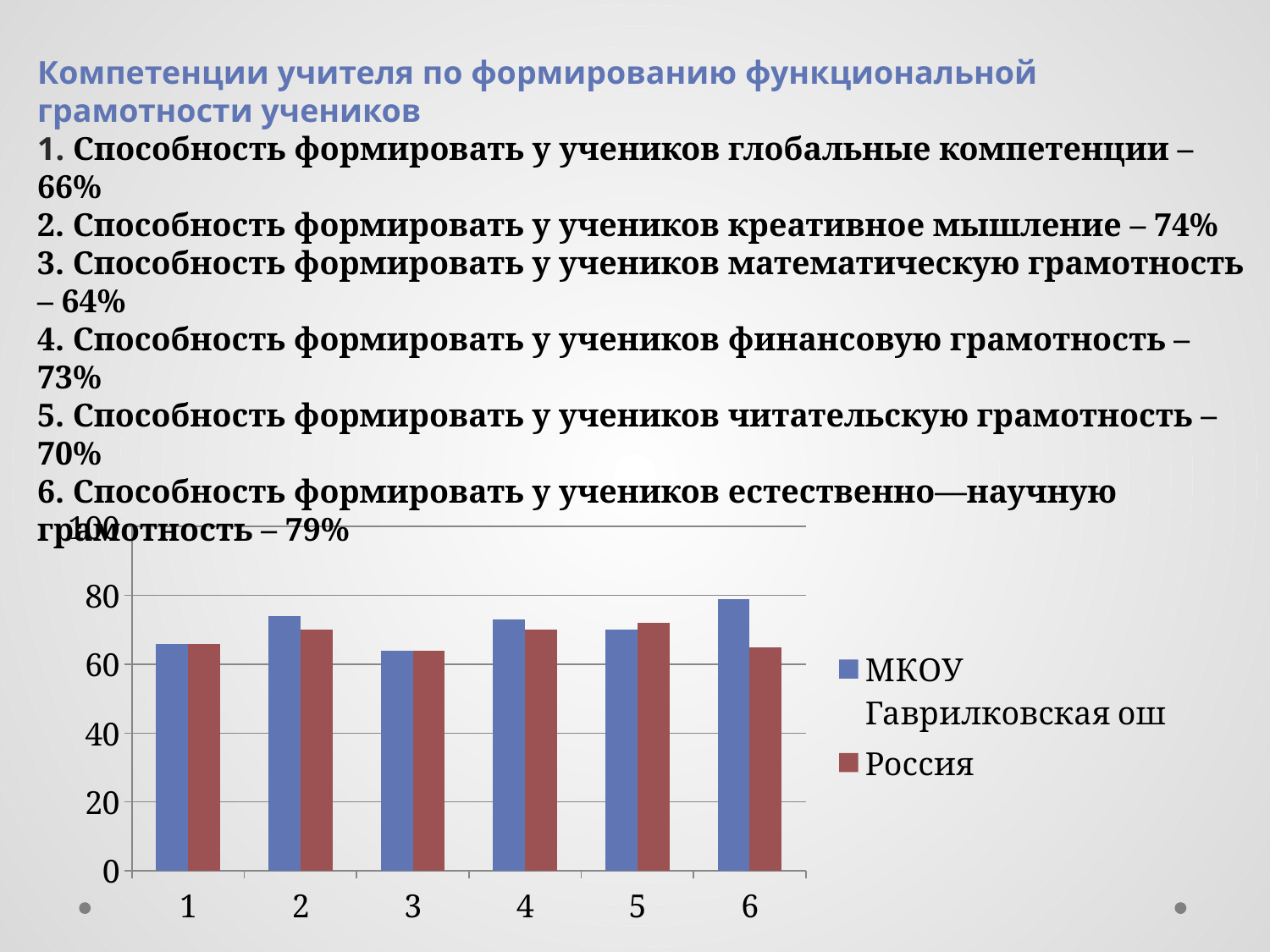
What kind of chart is shown on the slide? bar chart Is the value for Россия in category 6 greater or less than 80? less How many categories are shown on the x axis of the chart? 6 Which series is shown in red in the chart? Россия Is the value for МКОУ Гавриловская ош in category 6 greater or less than 60? greater For category 6, which series has the larger value, МКОУ Гавриловская ош or Россия? МКОУ Гавриловская ош Is the value for Россия in category 3 greater or less than 80? less What are the two series named in the chart legend? МКОУ Гаврилковская ош and Россия How many series does the chart legend list? 2 For category 2, which series has the larger value, МКОУ Гавриловская ош or Россия? МКОУ Гавриловская ош For which category is the МКОУ Гавриловская ош bar the highest? 6